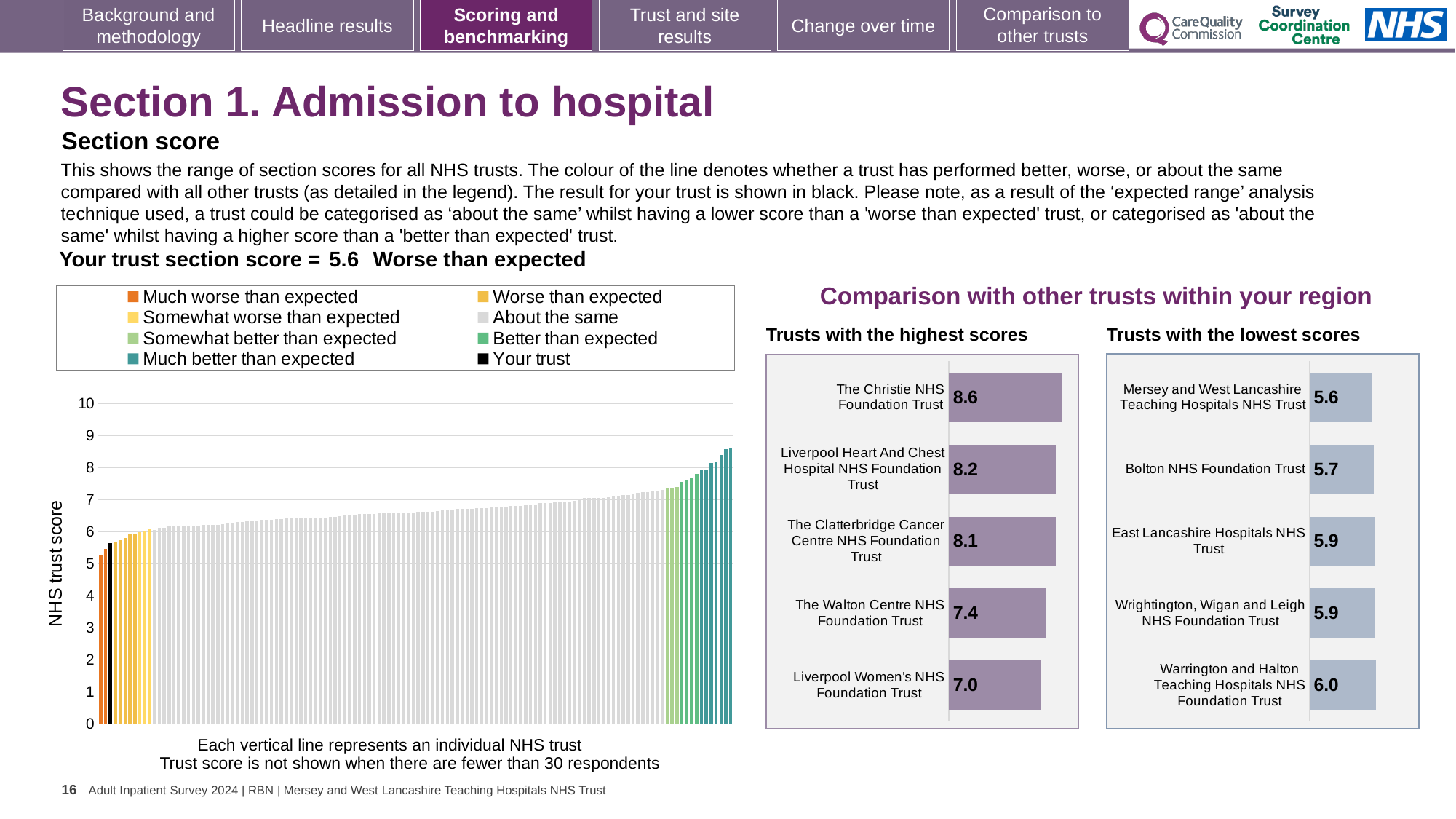
In the 'Trusts with the highest scores' chart, what is the score for The Christie NHS Foundation Trust? 8.6 In the 'Trusts with the highest scores' chart, what is the difference between the scores of The Christie NHS Foundation Trust and Liverpool Women's NHS Foundation Trust? 1.6 In the large NHS trust score chart on the left, do the trust scores rise or fall from left to right? rise In the 'Trusts with the highest scores' chart, what is the score for The Walton Centre NHS Foundation Trust? 7.4 How many categories does the legend of the large NHS trust score chart on the left list? 8 In the 'Trusts with the lowest scores' chart, which trust has the highest score? Warrington and Halton Teaching Hospitals NHS Foundation Trust In the large NHS trust score chart on the left, what is the section score for your trust? 5.6 In the 'Trusts with the highest scores' chart, is the score for The Clatterbridge Cancer Centre NHS Foundation Trust greater or less than 8.2? less In the 'Trusts with the lowest scores' chart, what is the score for Bolton NHS Foundation Trust? 5.7 In the 'Trusts with the lowest scores' chart, which is larger: the score for Mersey and West Lancashire Teaching Hospitals NHS Trust or the score for Warrington and Halton Teaching Hospitals NHS Foundation Trust? Warrington and Halton Teaching Hospitals NHS Foundation Trust In the 'Trusts with the lowest scores' chart, how many trusts are shown? 5 In the 'Trusts with the highest scores' chart, which trust has the lowest score? Liverpool Women's NHS Foundation Trust